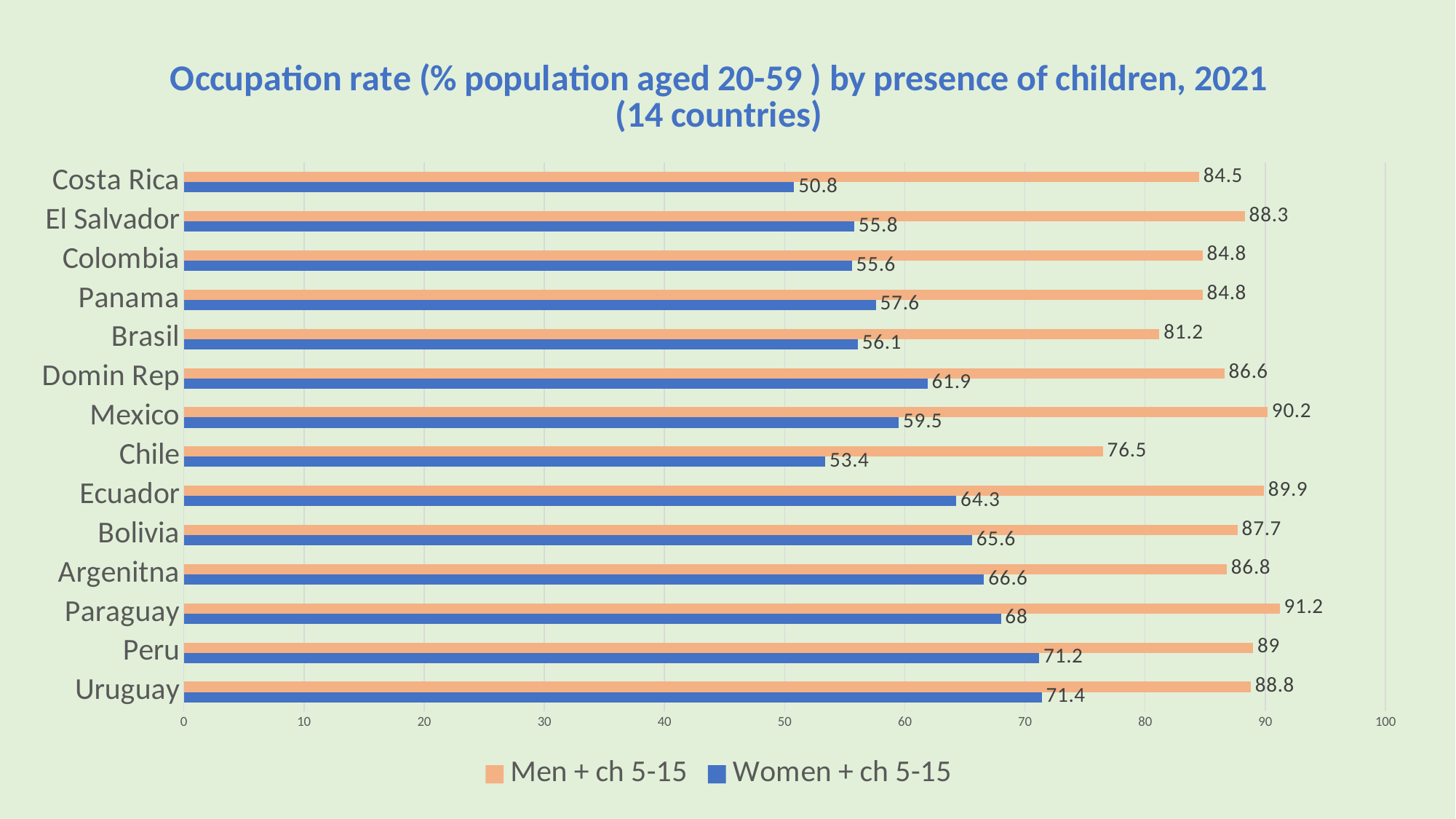
What kind of chart is shown on the slide? Bar chart How many series does the legend list? 2 Which is larger: the Women + ch 5-15 value for Peru or for Chile? Peru Which country has the highest value for Men + ch 5-15? Paraguay What is the difference between the Men + ch 5-15 and Women + ch 5-15 values for Costa Rica? 33.7 What is the value for Women + ch 5-15 in Domin Rep? 61.9 Which colour represents the Women + ch 5-15 series? Blue Which country has the lowest value for Men + ch 5-15? Chile Which country has the lowest value for Women + ch 5-15? Costa Rica How many countries are shown on the chart? 14 What is the value for Men + ch 5-15 in Paraguay? 91.2 What is the value for Women + ch 5-15 in Costa Rica? 50.8